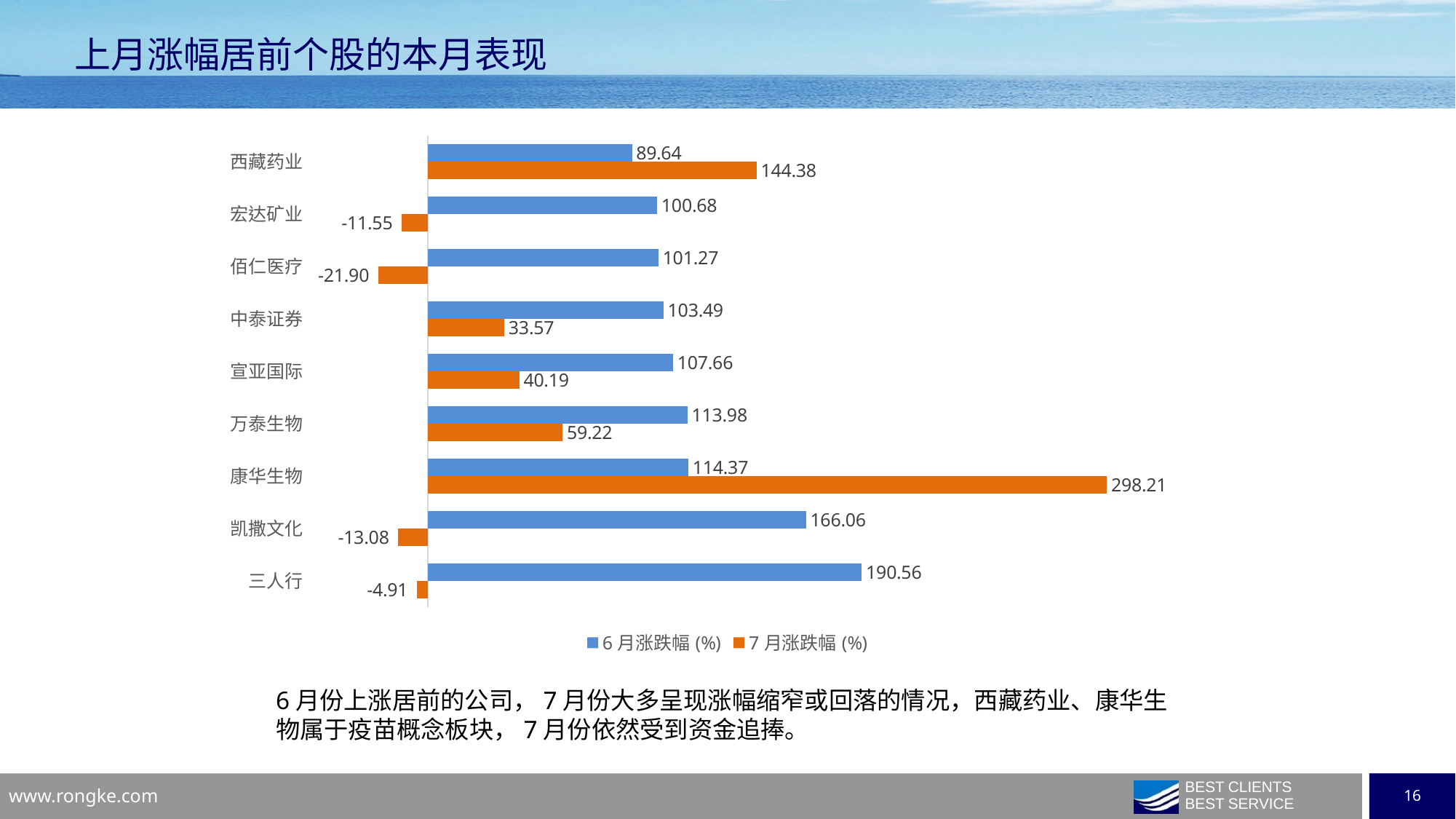
What is the difference between the 7 月涨跌幅 (%) and 6 月涨跌幅 (%) values for 西藏药业? 54.74 How many series does the legend list? 2 What type of chart is shown on the slide? Bar chart Which company has the lowest 6 月涨跌幅 (%)? 西藏药业 Which company has the highest 7 月涨跌幅 (%)? 康华生物 Which is larger for 万泰生物: the 6 月涨跌幅 (%) or the 7 月涨跌幅 (%)? 6 月涨跌幅 (%) What is the 7 月涨跌幅 (%) value for 佰仁医疗? -21.90 How many companies are shown in the chart? 9 Which colour represents the 7 月涨跌幅 (%) series? Orange Which company has the lowest 7 月涨跌幅 (%)? 佰仁医疗 What is the 6 月涨跌幅 (%) value for 三人行? 190.56 What is the 7 月涨跌幅 (%) value for 康华生物? 298.21